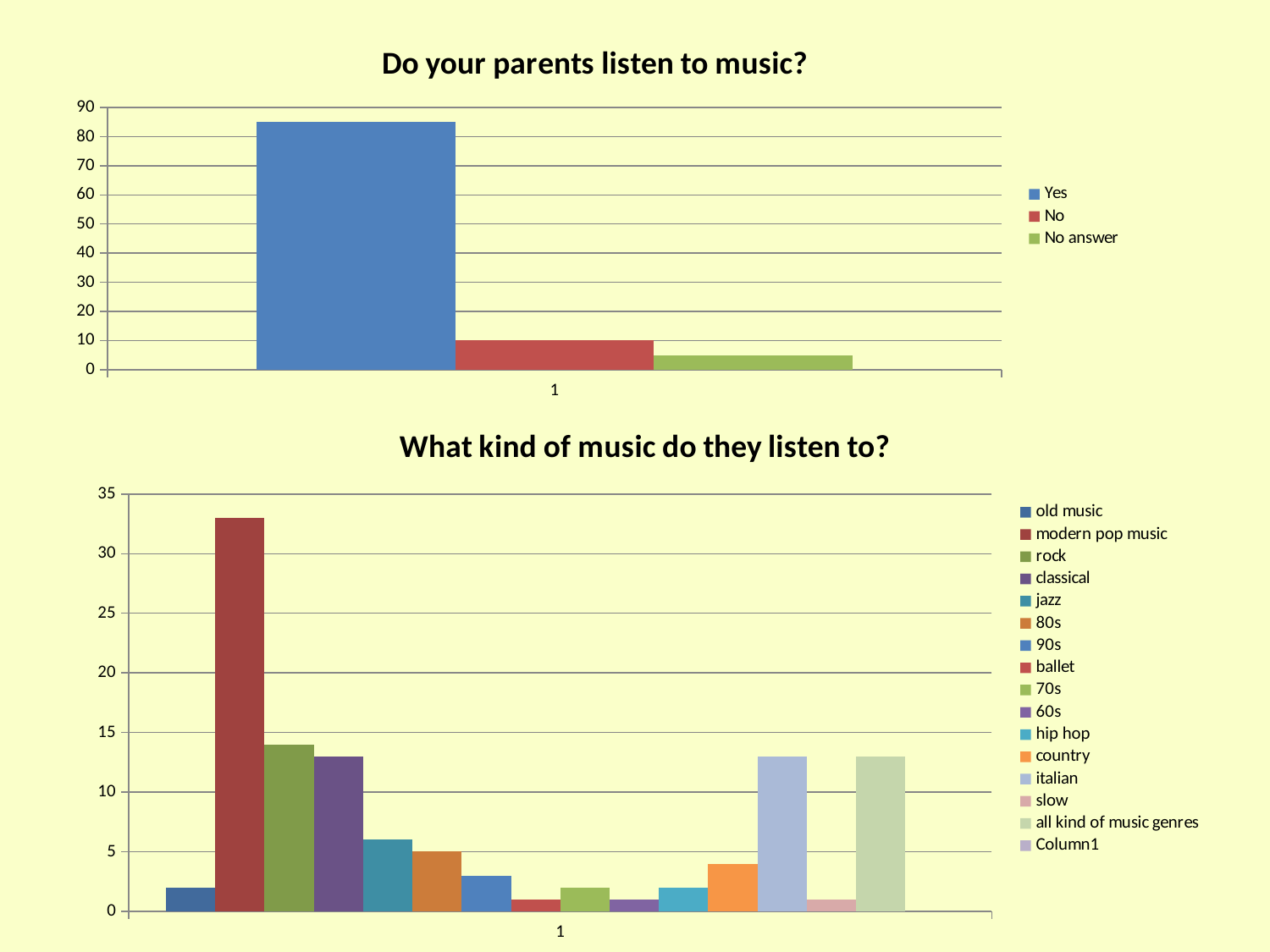
In the 'What kind of music do they listen to?' chart, which is larger, rock or jazz? rock In the 'Do your parents listen to music?' chart, is the value for No greater or less than 20? less In the 'Do your parents listen to music?' chart, is the value for Yes greater or less than 80? greater What kind of chart is the 'Do your parents listen to music?' chart? bar chart What kind of chart is the 'What kind of music do they listen to?' chart? bar chart In the 'Do your parents listen to music?' chart, which series has the highest value? Yes In the 'What kind of music do they listen to?' chart, is the value for modern pop music greater or less than 30? greater In the 'What kind of music do they listen to?' chart, which series has the highest value? modern pop music In the 'What kind of music do they listen to?' chart, how many entries does the legend list? 16 In the 'Do your parents listen to music?' chart, which series has the lowest value? No answer In the 'Do your parents listen to music?' chart, how many series does the legend list? 3